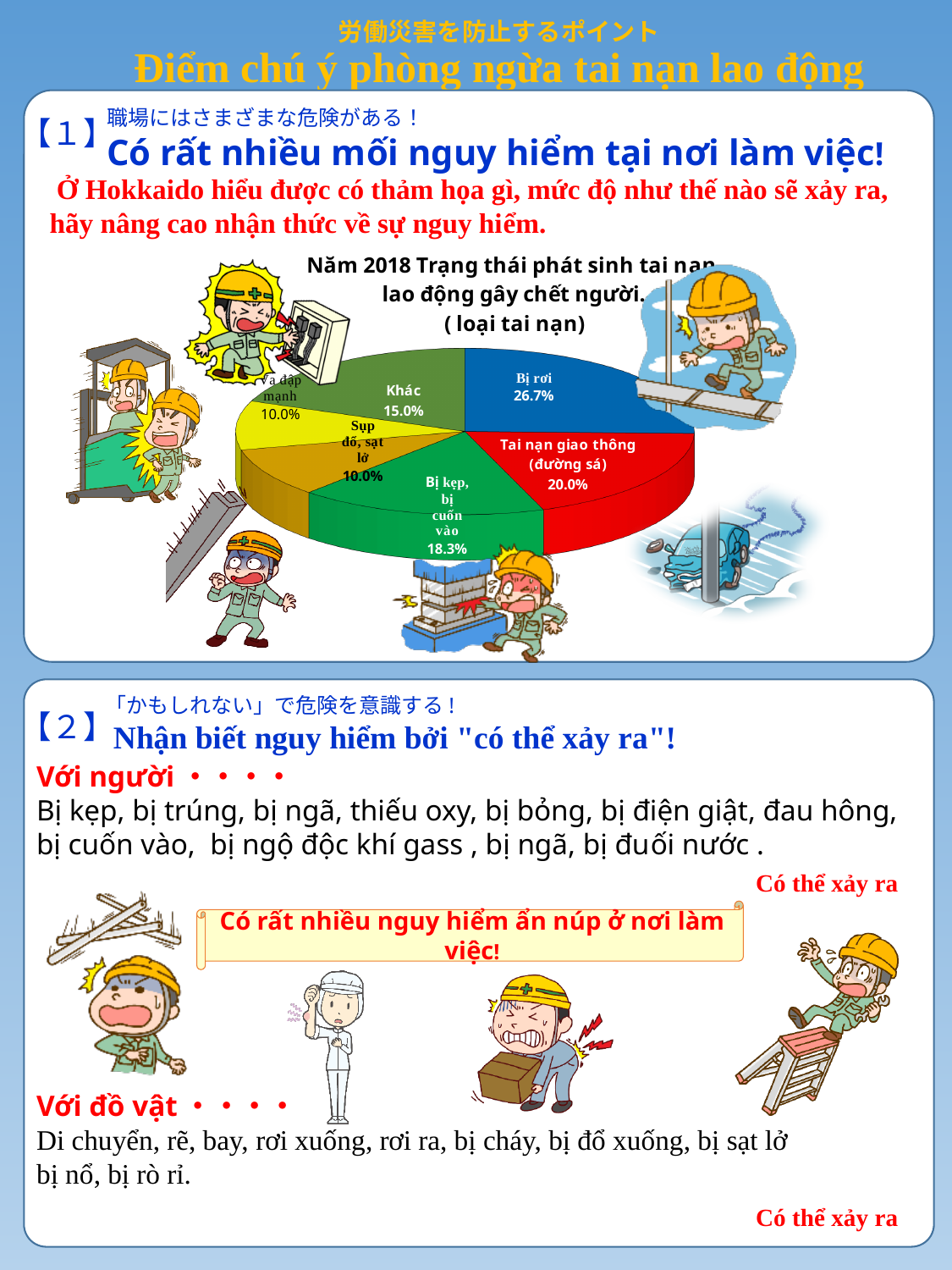
What is the difference between the shares of "Khác" and "Sụp đổ, sạt lở"? 5.0% What is the share for "Bị rơi" in the pie chart? 26.7% What is the difference between the shares of "Bị rơi" and "Tai nạn giao thông (đường sá)"? 6.7% How many slices does the pie chart have? 6 Which category has the largest share in the pie chart? Bị rơi What year does the pie chart title refer to? 2018 What is the share for "Bị kẹp, bị cuốn vào" in the pie chart? 18.3% What is the share for "Khác" in the pie chart? 15.0% Which is larger, the share for "Khác" or the share for "Bị kẹp, bị cuốn vào"? Bị kẹp, bị cuốn vào What is the share for "Sụp đổ, sạt lở" in the pie chart? 10.0% What is the share for "Tai nạn giao thông (đường sá)" in the pie chart? 20.0% What kind of chart is shown on the slide? Pie chart